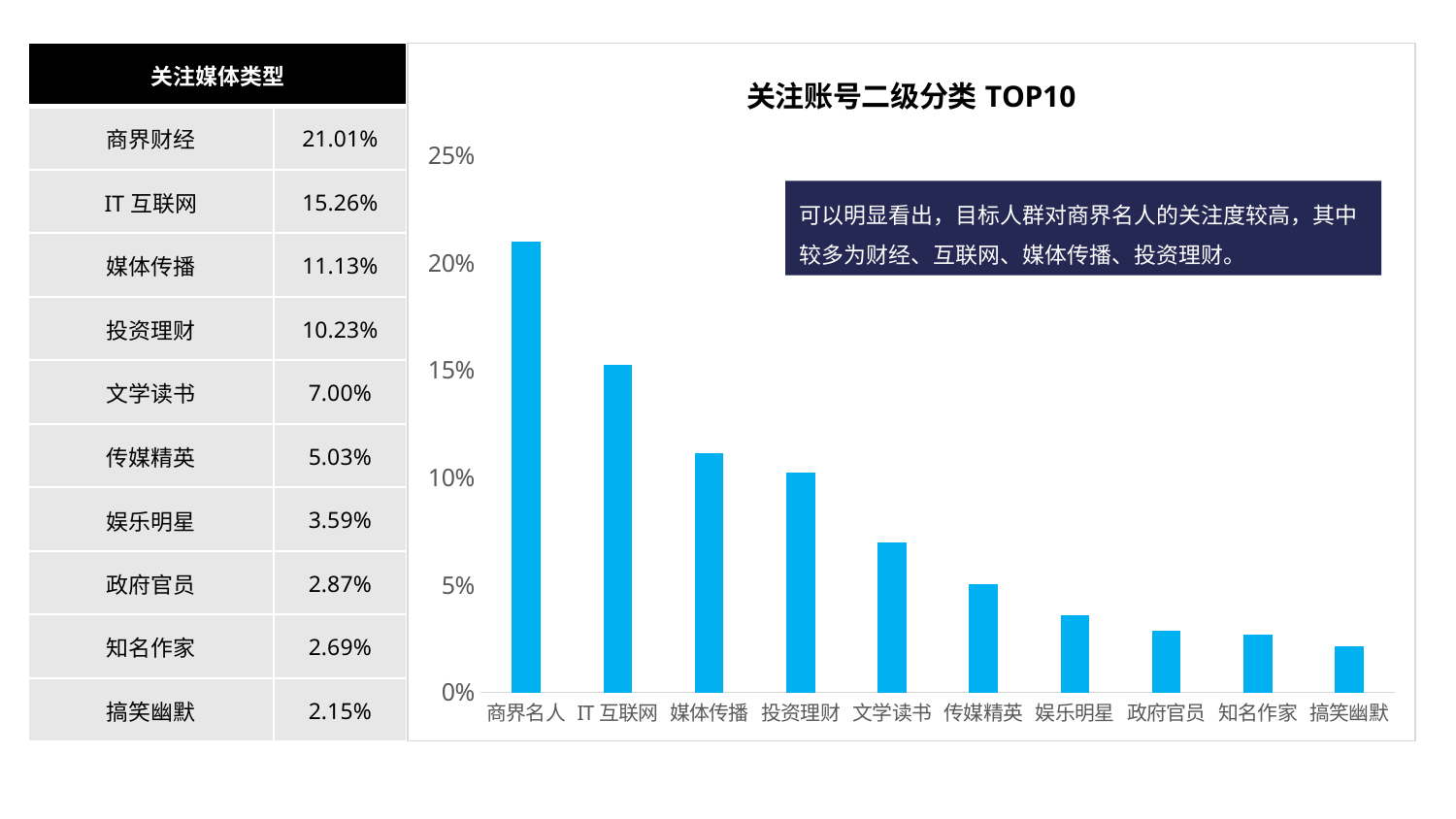
Is the value for 文学读书 greater or less than 10%? less What is the title of the chart? 关注账号二级分类 TOP10 According to the table on the slide, what is the value for 投资理财? 10.23% Which is larger, the value for IT 互联网 or the value for 媒体传播? IT 互联网 What kind of chart is shown on the slide? bar chart Is the value for 商界名人 greater or less than 20%? greater How many categories are shown on the x axis of the chart? 10 Which category has the highest bar in the chart? 商界名人 Which category has the lowest bar in the chart? 搞笑幽默 Do the bar values rise or fall from left to right along the x axis? fall According to the table on the slide, what is the value for 娱乐明星? 3.59%